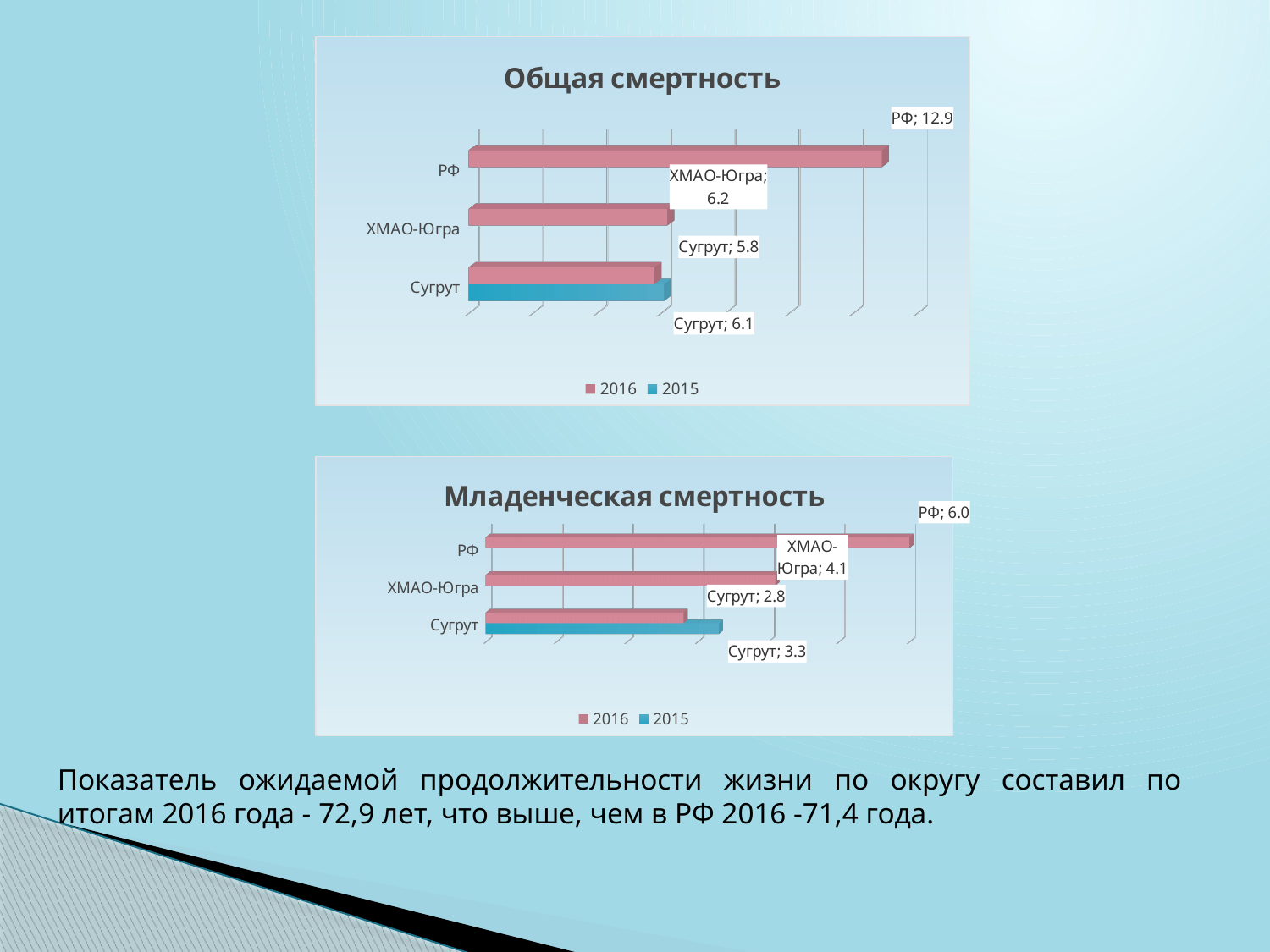
In the chart titled "Младенческая смертность", which category has the lowest 2016 value? Сугрут How many series does the legend of the chart titled "Младенческая смертность" list? 2 In the chart titled "Общая смертность", which category has the highest 2016 value? РФ In the chart titled "Младенческая смертность", what is the 2016 value for Сугрут? 2.8 In the chart titled "Общая смертность", what is the 2016 value for ХМАО-Югра? 6.2 In the chart titled "Общая смертность", which is larger for Сугрут: the 2016 value or the 2015 value? 2015 In the chart titled "Общая смертность", what is the 2015 value for Сугрут? 6.1 In the chart titled "Младенческая смертность", what is the difference between the 2015 and 2016 values for Сугрут? 0.5 In the chart titled "Общая смертность", what is the difference between the 2016 values for РФ and ХМАО-Югра? 6.7 In the chart titled "Младенческая смертность", what is the 2016 value for РФ? 6.0 In the chart titled "Общая смертность", what is the 2016 value for РФ? 12.9 What type of chart is the chart titled "Общая смертность"? Bar chart